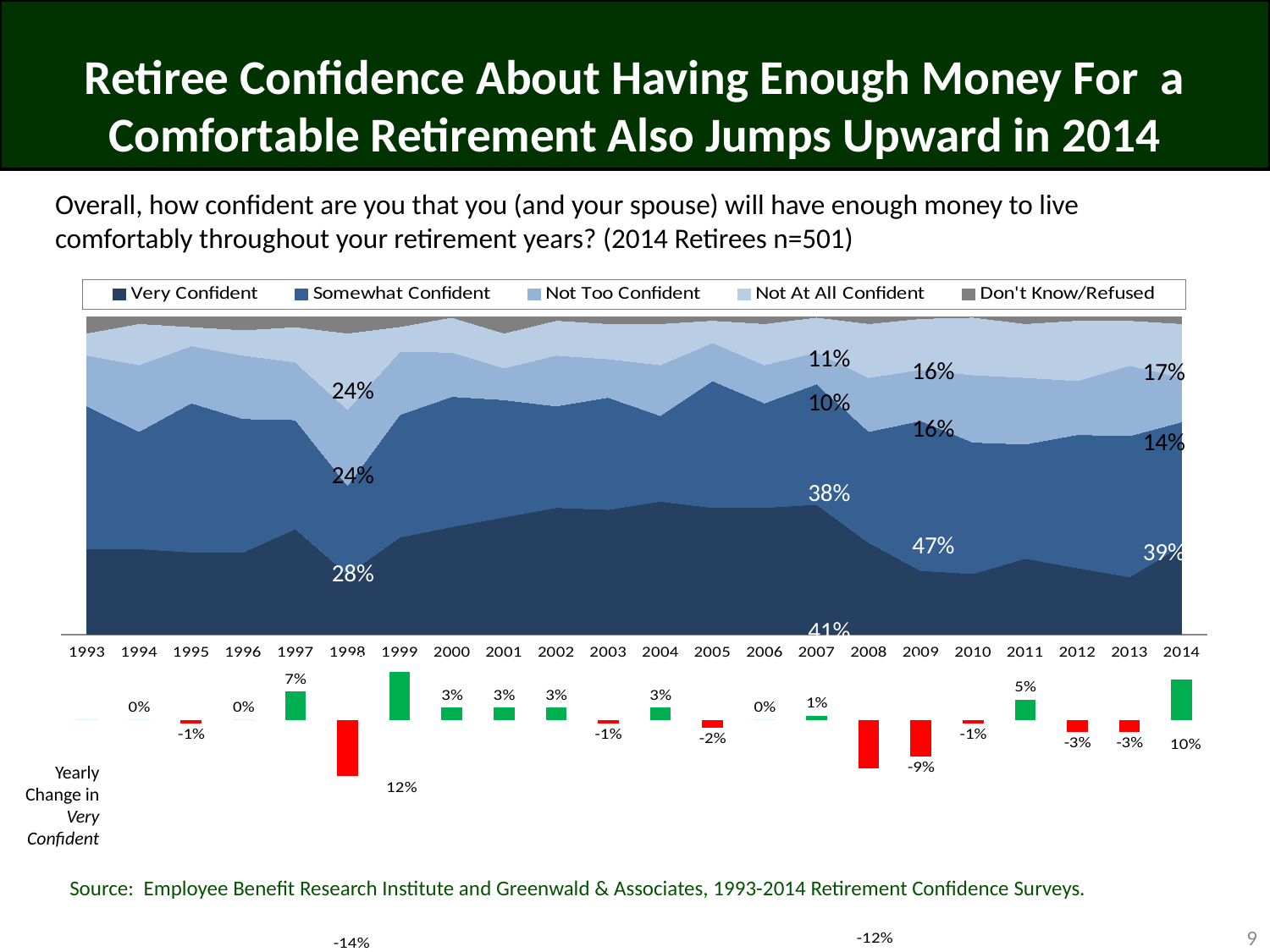
In the lower bar chart of yearly change in Very Confident, which year has the lowest value? 1998 In the upper chart, which year has the larger Somewhat Confident value, 2007 or 2009? 2009 In the upper chart, what is the Somewhat Confident value for 2009? 47% In the lower bar chart of yearly change in Very Confident, what is the value for 2014? 10% How many years are shown along the x axis of the upper chart? 22 How many series does the legend of the stacked area chart list? 5 In the lower bar chart of yearly change in Very Confident, what is the value for 2009? -9% What kind of chart is the upper chart showing confidence levels by year? Area chart In the upper chart, what is the difference between the Not At All Confident and Not Too Confident values in 2014? 3 percentage points In the upper chart, what is the Not At All Confident value for 2007? 11%